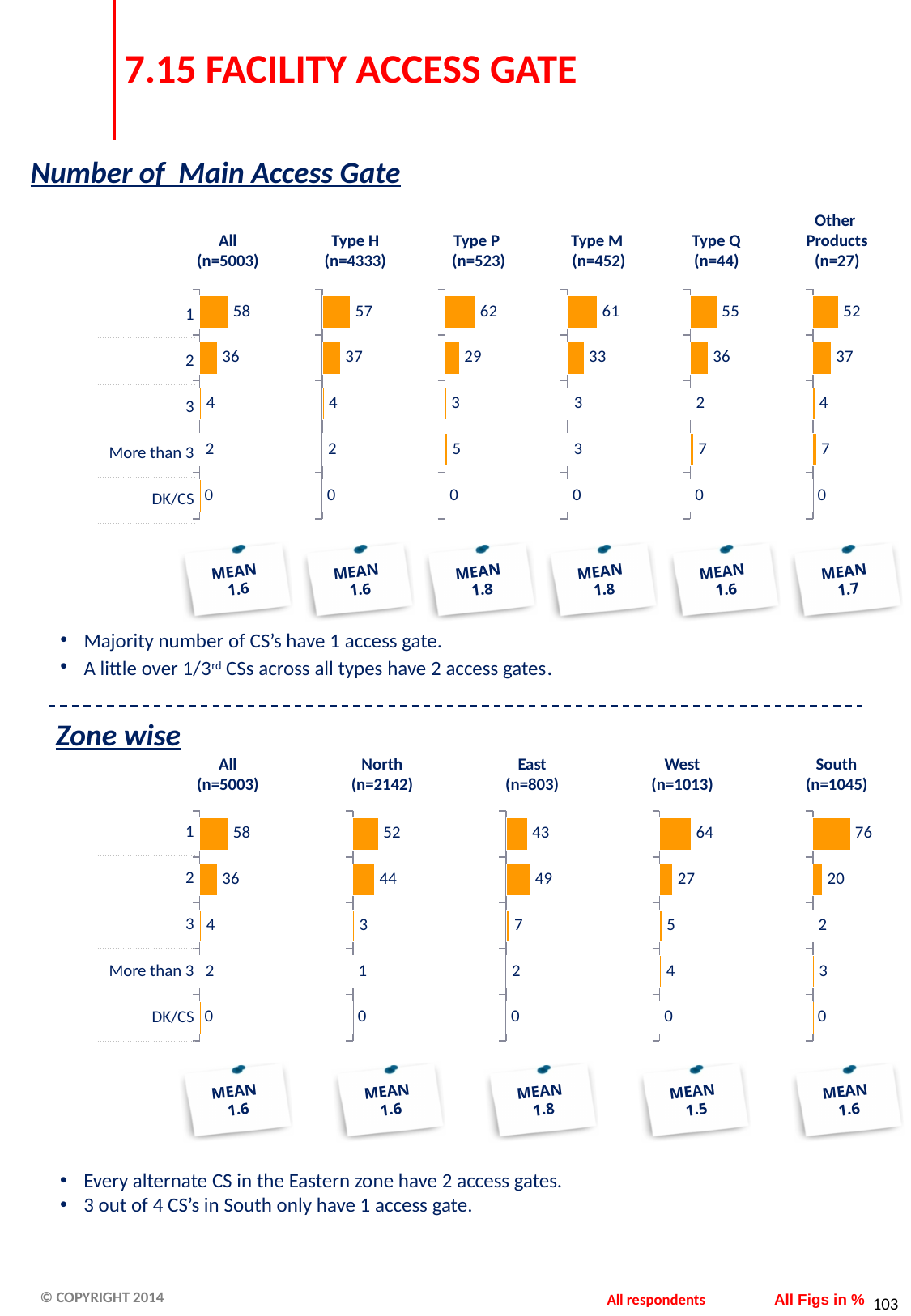
In the Number of Main Access Gate section, what is the value for 1 gate in the All (n=5003) chart? 58 In the Number of Main Access Gate section, what is the difference between the values for 1 gate and 2 gates in the Type M (n=452) chart? 28 In the Zone wise section, how many categories are shown in the North (n=2142) chart? 5 In the Number of Main Access Gate section, which category has the highest value in the Other Products (n=27) chart? 1 In the Zone wise section, what is the value for 1 gate in the South (n=1045) chart? 76 In the Zone wise section, what is the difference between the values for 1 gate and 2 gates in the West (n=1013) chart? 37 What type of chart is used in the Number of Main Access Gate section? Bar chart In the Number of Main Access Gate section, what is the value for More than 3 in the Type Q (n=44) chart? 7 In the Number of Main Access Gate section, what is the value for 2 gates in the Type P (n=523) chart? 29 In the Zone wise section, what mean value is shown for the West (n=1013) chart? 1.5 In the Zone wise section, what is the value for 2 gates in the East (n=803) chart? 49 In the Zone wise section, which is larger in the East (n=803) chart: the value for 1 gate or the value for 2 gates? 2 gates